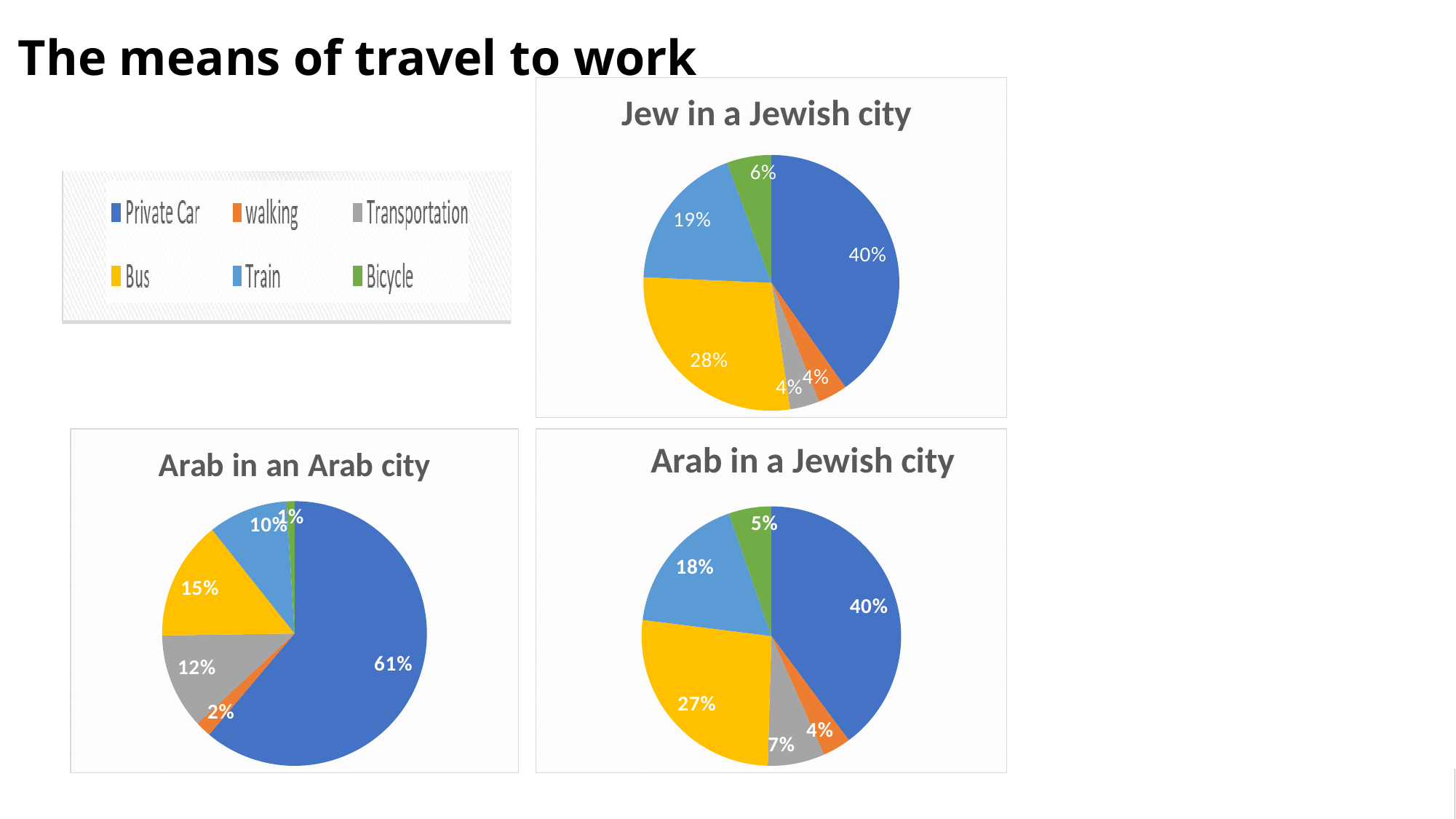
What kind of chart is 'Arab in a Jewish city'? Pie chart In the 'Jew in a Jewish city' chart, what share is Private Car? 40% Which colour represents Bus in the legend? Yellow In the 'Arab in a Jewish city' chart, what share is Train? 18% In the 'Arab in a Jewish city' chart, what share is Transportation? 7% How many means of travel does the legend list? 6 In the 'Arab in an Arab city' chart, what is the difference between the Private Car share and the Bus share? 46% In the 'Arab in an Arab city' chart, what share is Private Car? 61% In the 'Arab in a Jewish city' chart, what share is Bus? 27% In the 'Jew in a Jewish city' chart, which is larger, Train or Bus? Bus In the 'Arab in an Arab city' chart, which means of travel has the smallest share? Bicycle In the 'Jew in a Jewish city' chart, which means of travel has the largest share? Private Car